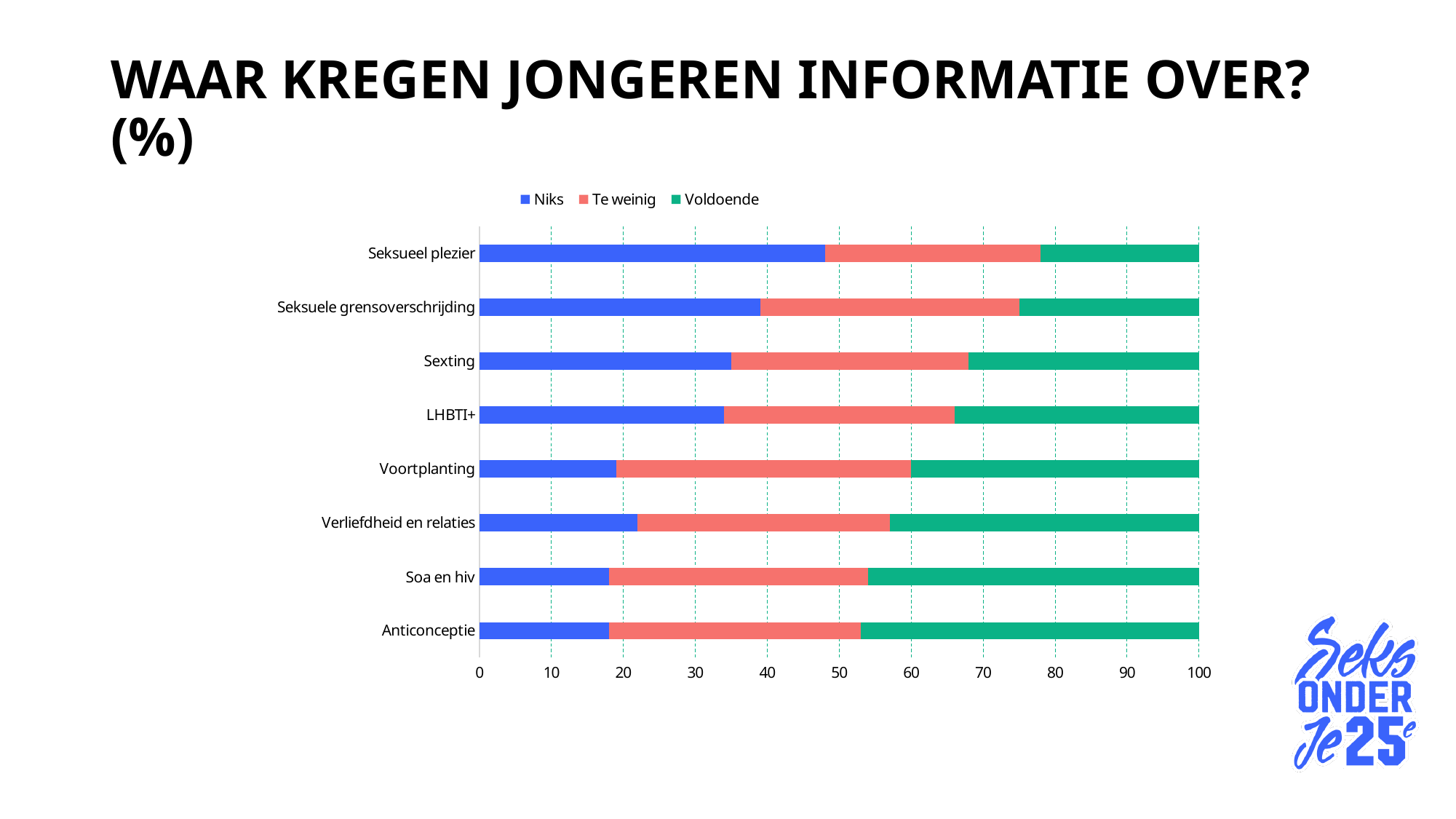
What are the three legend entries of the chart? Niks, Te weinig, Voldoende Is the 'Niks' value for Verliefdheid en relaties greater or less than 30? less How many categories are listed on the vertical axis of the chart? 8 Which category has the highest value for the 'Niks' series? Seksueel plezier Which has a larger 'Niks' value: Seksuele grensoverschrijding or Soa en hiv? Seksuele grensoverschrijding What kind of chart is shown on the slide? Stacked bar chart Is the 'Niks' value for Seksueel plezier greater or less than 40? greater What is the title of the chart on the slide? WAAR KREGEN JONGEREN INFORMATIE OVER? (%) What is the total of the stacked bar for Sexting? 100 Is the 'Niks' value for Sexting greater or less than 30? greater How many series does the legend list? 3 Which has a larger 'Niks' value: Seksueel plezier or Voortplanting? Seksueel plezier